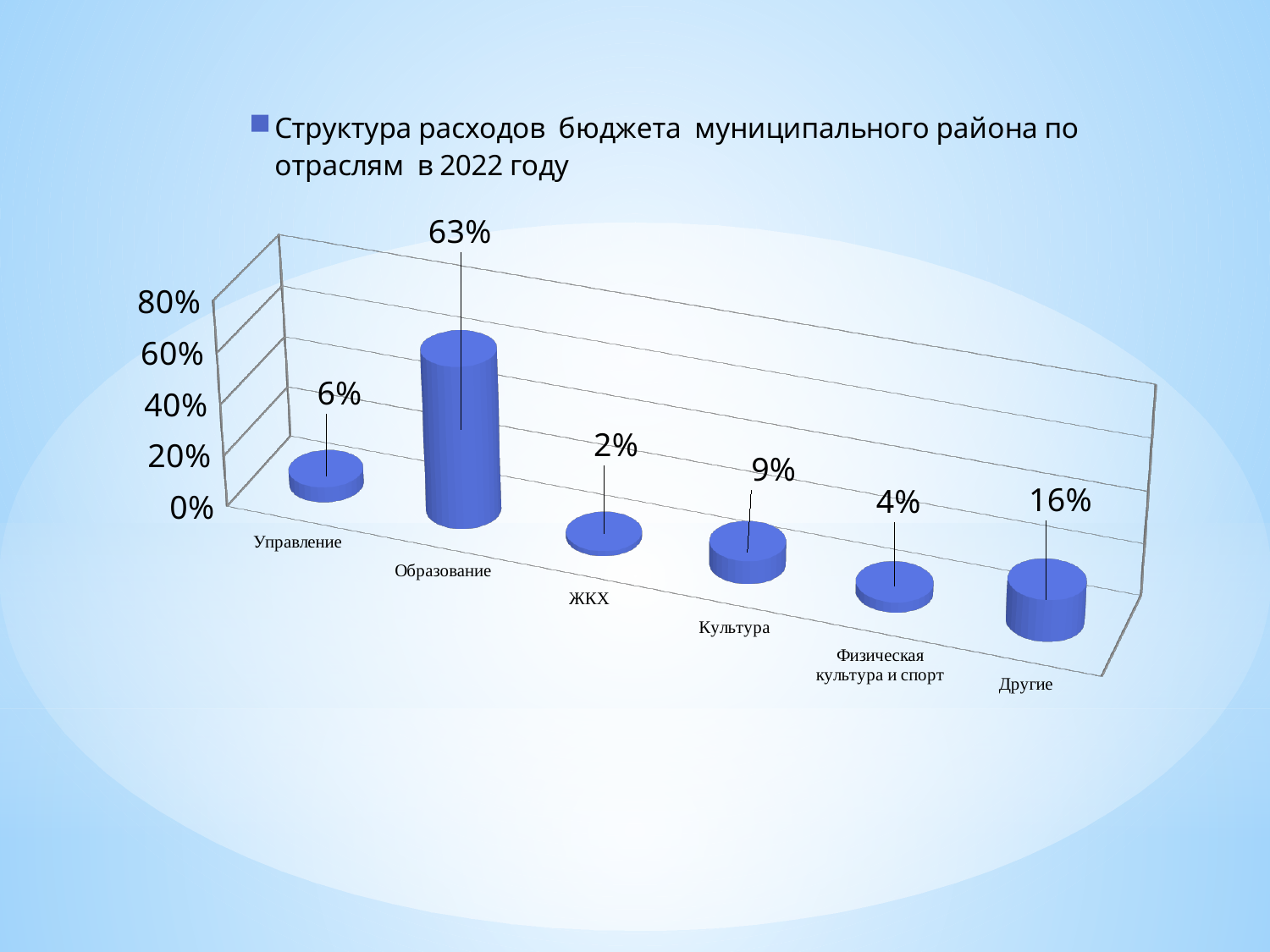
What is the value for Образование? 63% What is the value for Другие? 16% How many categories are shown on the chart? 6 Which category has the highest value? Образование What is the legend entry shown above the chart? Структура расходов бюджета муниципального района по отраслям в 2022 году What kind of chart is shown on the slide? bar chart What is the value for Физическая культура и спорт? 4% What is the difference between the values for Другие and Культура? 7% What is the value for Управление? 6% Which is larger, the value for Культура or the value for Управление? Культура Is the value for Образование greater or less than 40%? greater Which category has the lowest value? ЖКХ